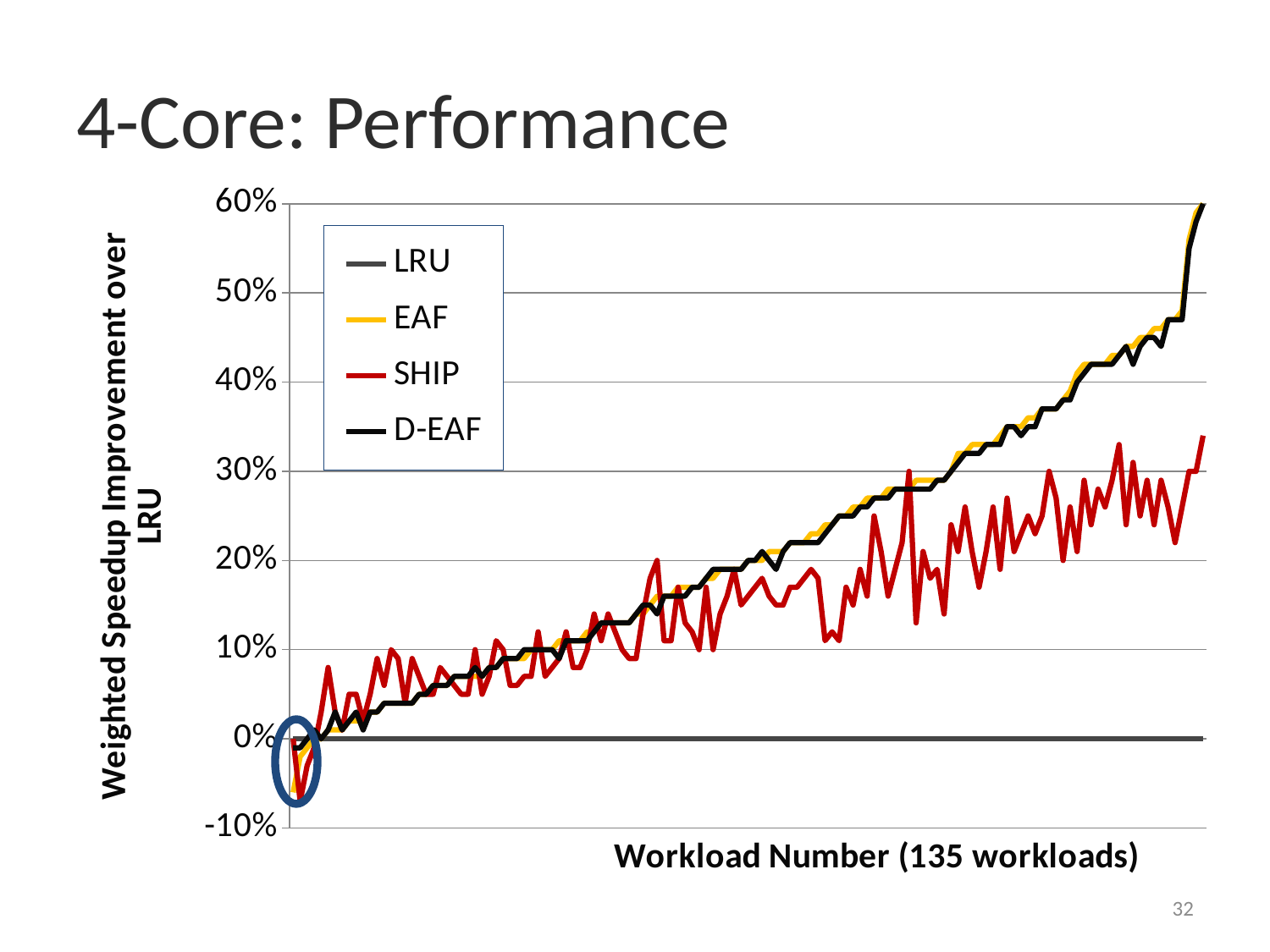
What is the title of the slide's chart? 4-Core: Performance At the rightmost workload, which is larger, the D-EAF value or the SHIP value? D-EAF Is the lowest SHIP value greater or less than 0%? less What is the label of the y axis? Weighted Speedup Improvement over LRU Do the EAF and D-EAF values rise or fall as the workload number increases? rise Which series has the lowest values over most of the workloads, excluding the flat LRU baseline? SHIP How many series does the legend list? 4 How many workloads are plotted along the x axis? 135 What value does the LRU line hold across all workloads? 0% What type of chart is shown on the slide? line chart Is the D-EAF value for the rightmost workload greater or less than 50%? greater Is the highest SHIP value greater or less than 40%? less